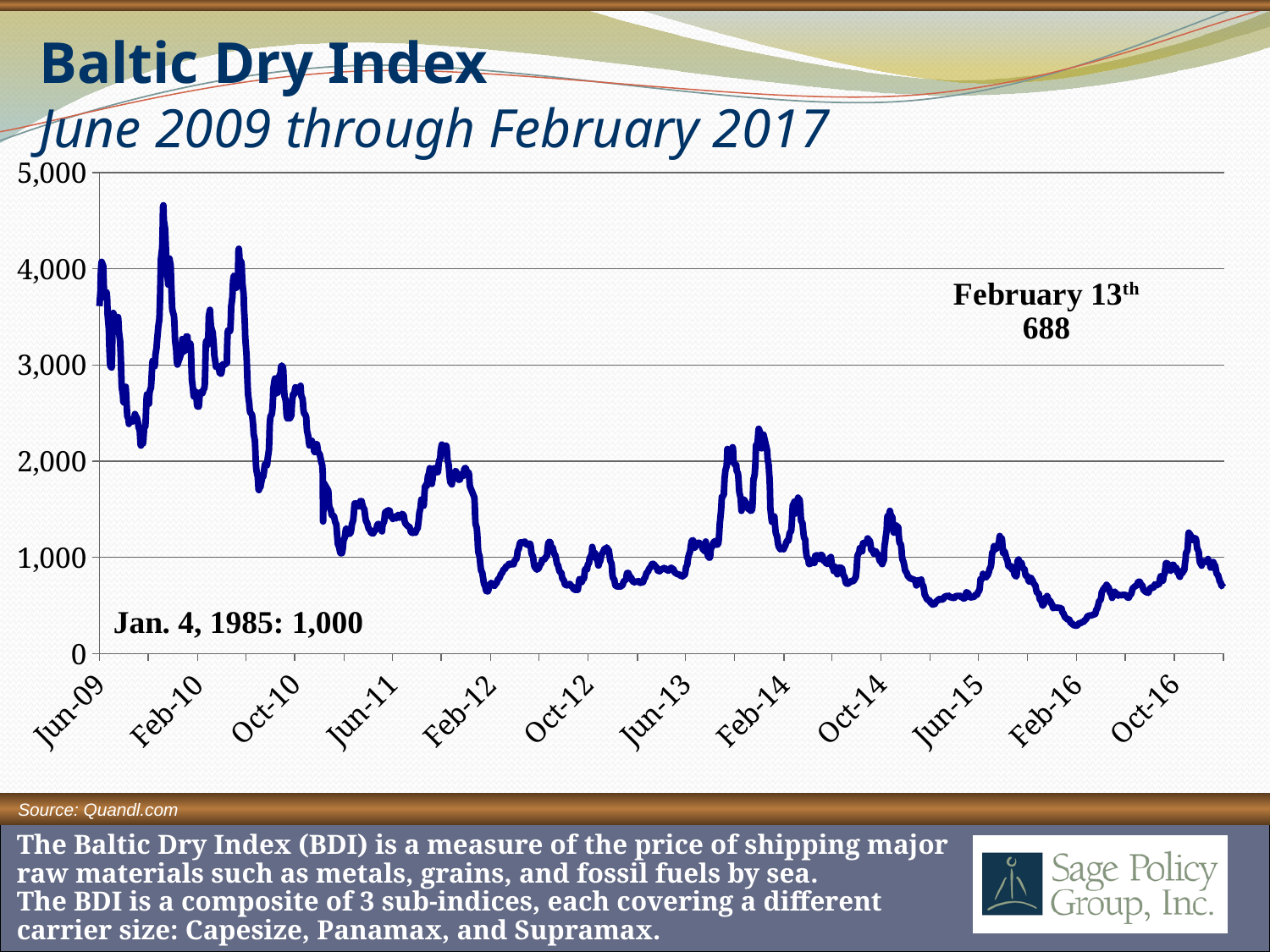
Is the value of the index at Jun-09 greater or less than 3,000? greater What is the title of the chart? Baltic Dry Index What source is cited for the chart data? Quandl.com What kind of chart is shown on the slide? line chart Is the value of the index at Jun-11 greater or less than 2,000? less Is the highest peak of the index, near Feb-10, greater or less than 4,000? greater Which is larger, the index value at Jun-09 or at Oct-16? Jun-09 What value of the Baltic Dry Index is annotated for February 13th? 688 How many date labels are shown on the x axis? 12 What value is annotated for Jan. 4, 1985? 1,000 Overall, does the Baltic Dry Index rise or fall from June 2009 to February 2017? fall